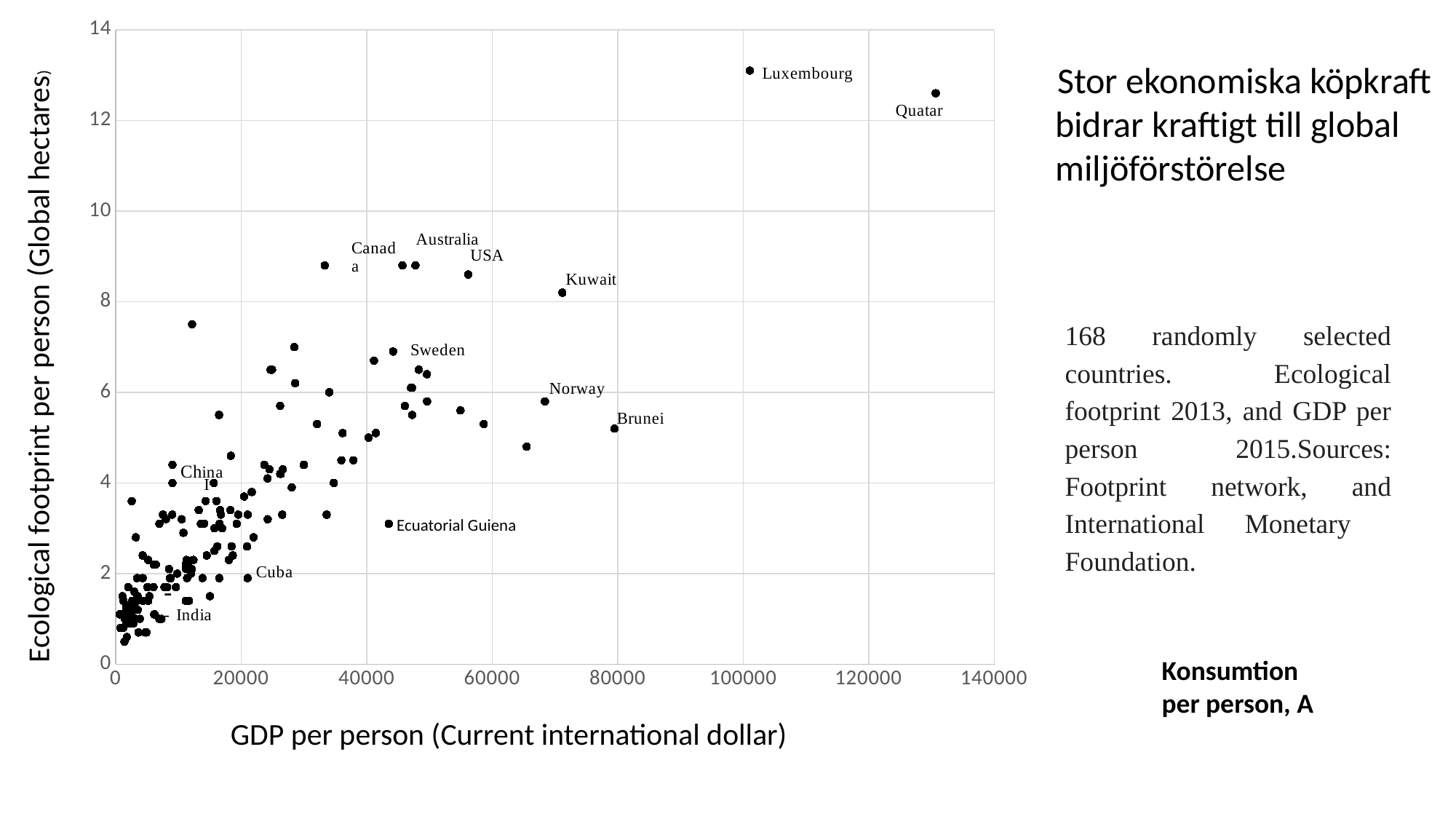
Which has the higher ecological footprint per person, Kuwait or Brunei? Kuwait Is the ecological footprint per person for Luxembourg greater or less than 12? greater Which has the higher ecological footprint per person, Luxembourg or Quatar? Luxembourg Which labelled country has the lowest ecological footprint per person? India Is the GDP per person for Quatar greater or less than 120000? greater Is the GDP per person for Brunei greater or less than 60000? greater What is the title of the x axis? GDP per person (Current international dollar) What kind of chart is shown on the slide? scatter plot Which labelled country has the highest GDP per person? Quatar Which labelled country has the highest ecological footprint per person? Luxembourg Does the ecological footprint per person generally rise or fall as GDP per person increases? rise